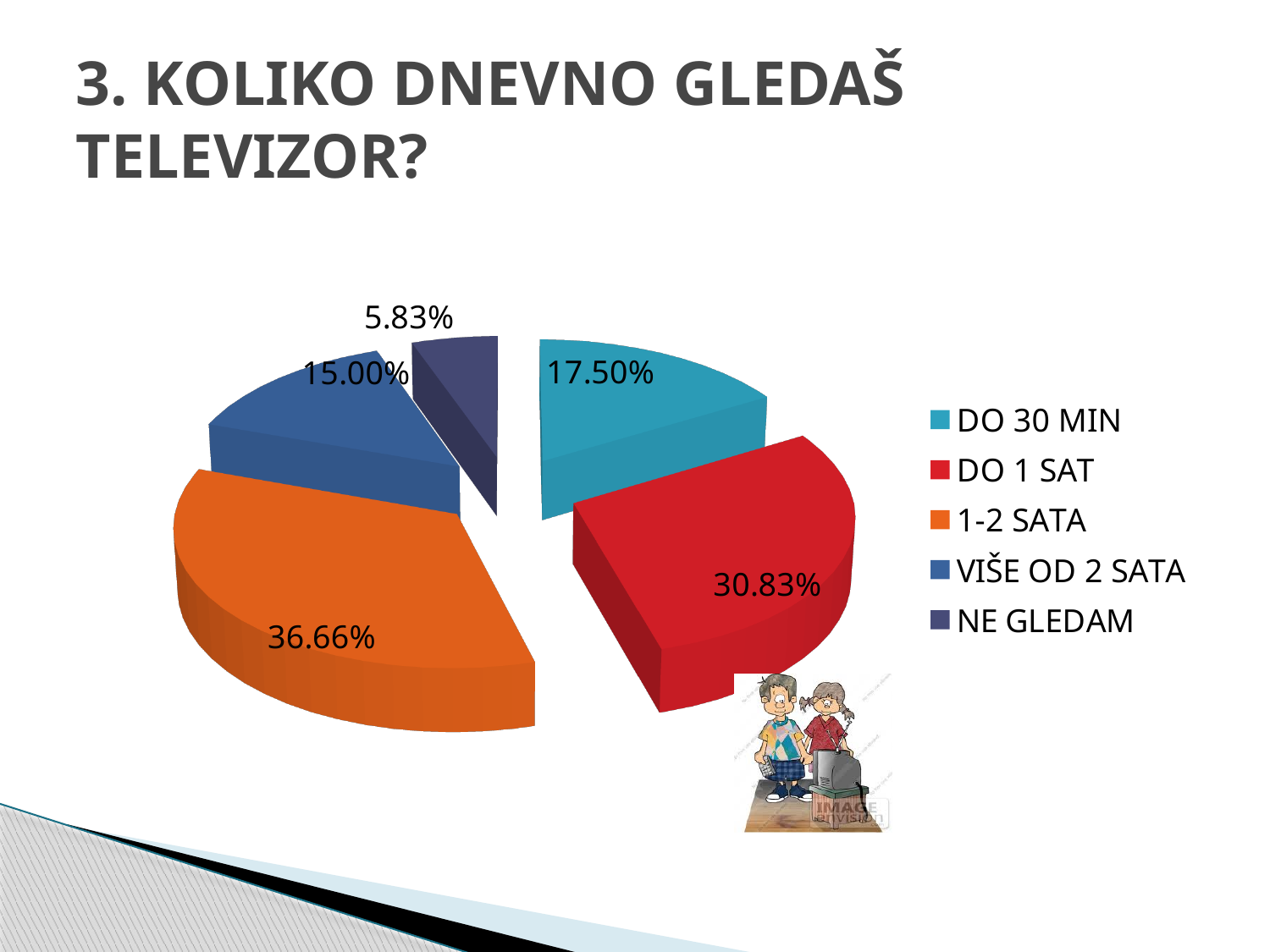
What percentage of the pie is labelled for VIŠE OD 2 SATA? 15.00% What percentage of the pie is labelled for DO 1 SAT? 30.83% How many categories does the pie chart show? 5 What colour is the slice for DO 1 SAT? red What percentage of the pie is labelled for DO 30 MIN? 17.50% What percentage of the pie is labelled for NE GLEDAM? 5.83% What percentage of the pie is labelled for 1-2 SATA? 36.66% Which category has the smallest slice of the pie? NE GLEDAM Which slice is larger, DO 30 MIN or VIŠE OD 2 SATA? DO 30 MIN Which category has the largest slice of the pie? 1-2 SATA What is the difference in percentage points between the 1-2 SATA slice and the DO 1 SAT slice? 5.83 What kind of chart is shown on the slide? pie chart